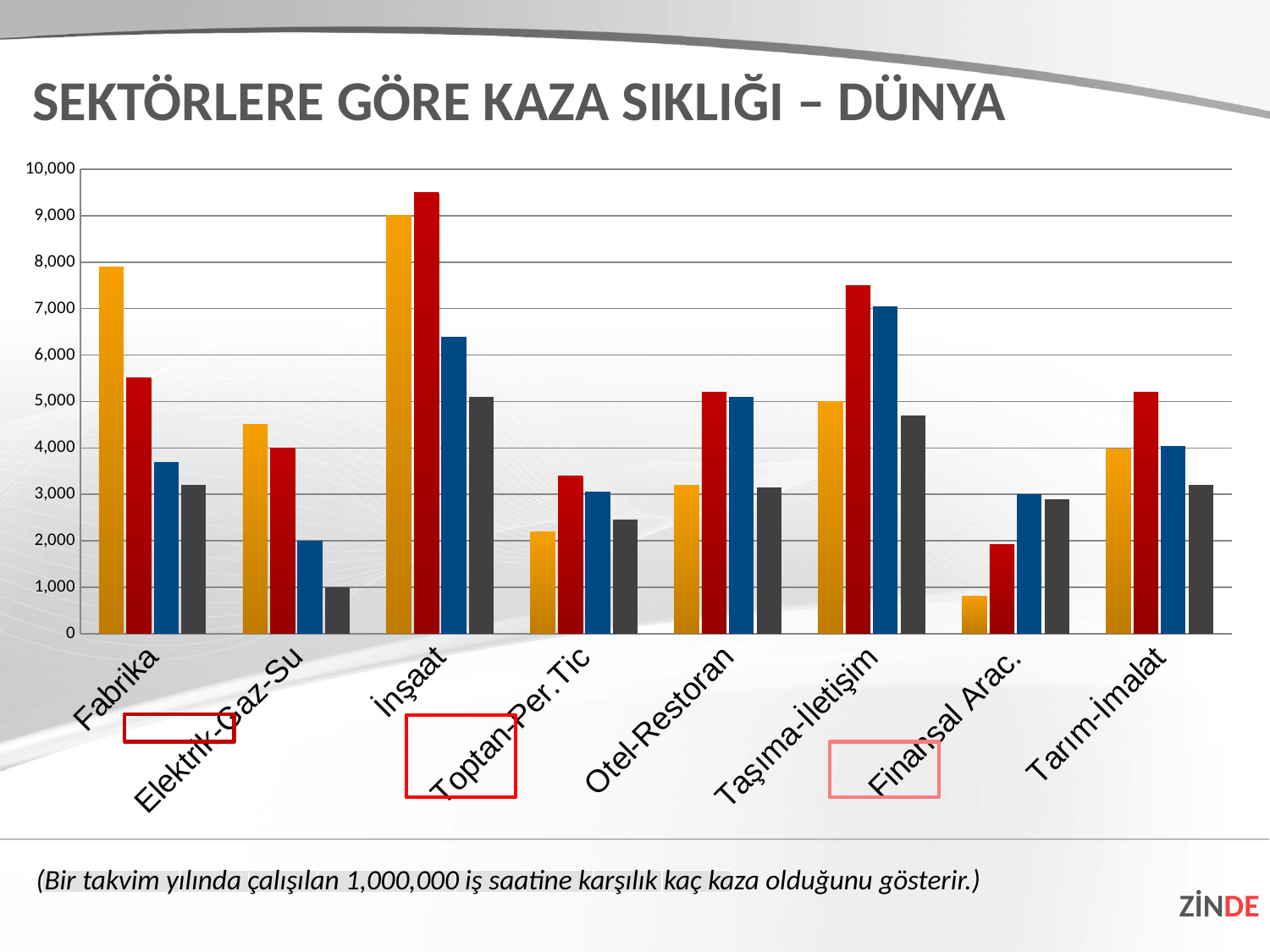
Which sector has the tallest bar in the chart? İnşaat Is the value of the orange bar for Toptan-Per.Tic greater or less than 3,000? less Which is larger: the orange bar for Fabrika or the orange bar for Elektrik-Gaz-Su? Fabrika How many bars are plotted for each sector category? 4 Is the value of the red bar for Taşıma-İletişim greater or less than 7,000? greater Which sector has the shortest bar in the chart? Finansal Arac. Is the value of the red bar for İnşaat greater or less than 9,000? greater What is the title of the chart on the slide? SEKTÖRLERE GÖRE KAZA SIKLIĞI – DÜNYA How many sector categories are shown on the x axis of the chart? 8 What kind of chart is shown on the slide? bar chart